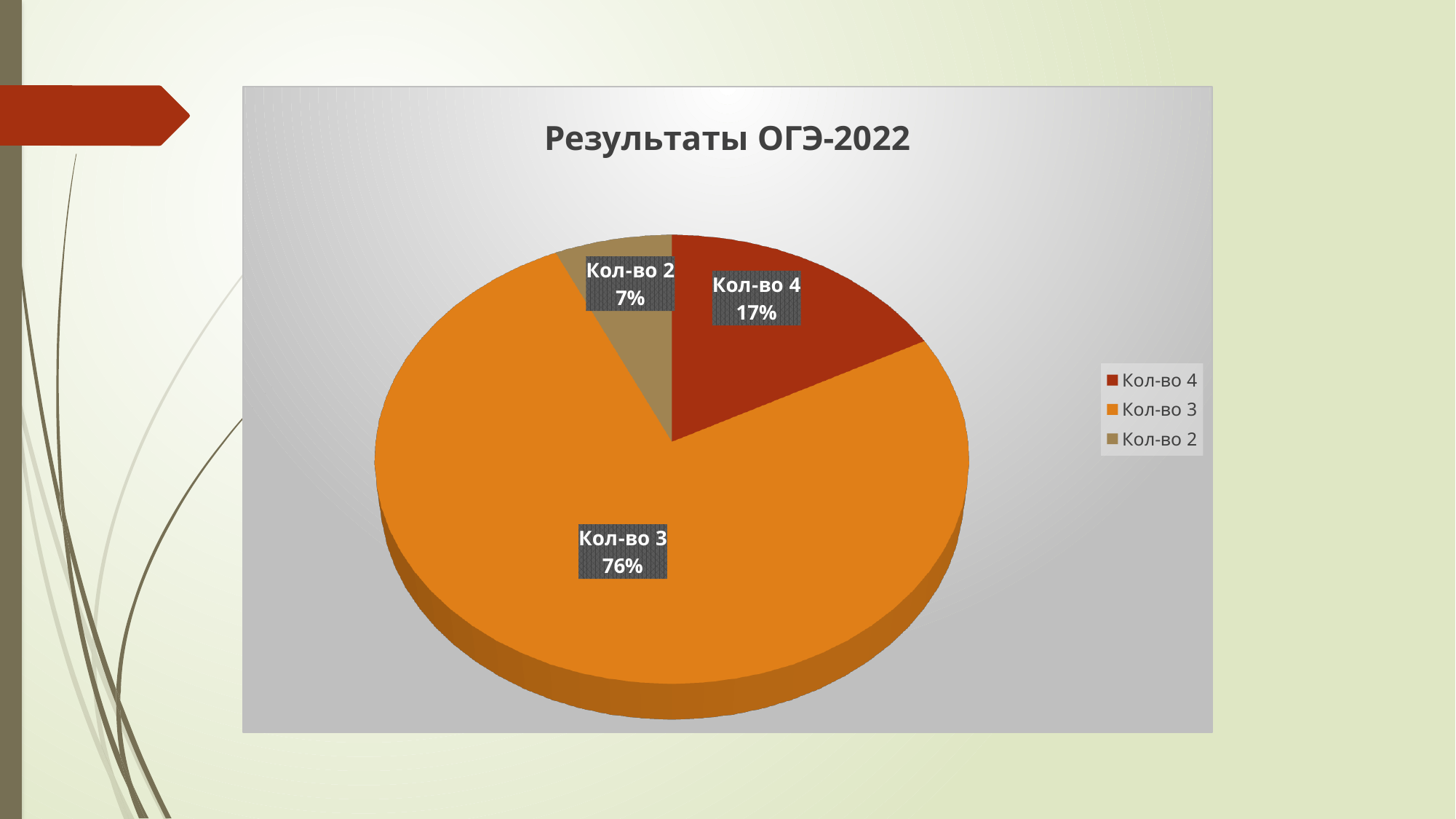
How many entries does the legend list? 3 What colour is the slice for Кол-во 4? dark red Which category has the largest slice of the pie? Кол-во 3 What share of the pie does Кол-во 2 take? 7% What kind of chart is shown on the slide? pie chart What is the difference in percentage points between Кол-во 3 and Кол-во 4? 59 Which is larger, the share for Кол-во 4 or the share for Кол-во 2? Кол-во 4 How many slices does the pie chart have? 3 What is the title of the chart? Результаты ОГЭ-2022 What share of the pie does Кол-во 3 take? 76% Which category has the smallest slice of the pie? Кол-во 2 What share of the pie does Кол-во 4 take? 17%